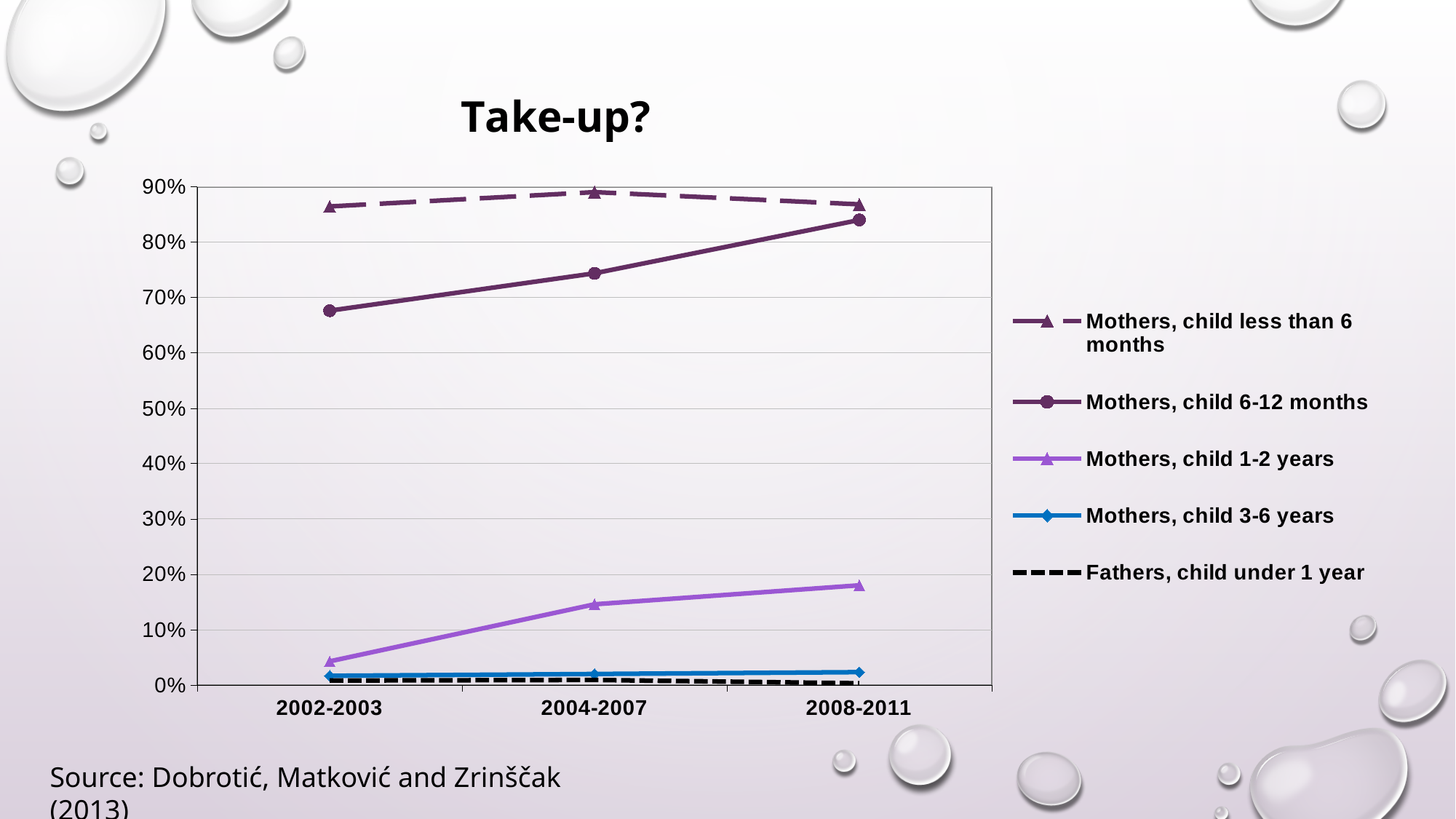
In 2004-2007, which is larger: Mothers, child less than 6 months or Mothers, child 6-12 months? Mothers, child less than 6 months Is the value for Mothers, child 6-12 months in 2008-2011 greater or less than 80%? greater How many series does the legend list? 5 What is the title of the chart? Take-up? Is the value for Mothers, child 1-2 years in 2008-2011 greater or less than 20%? less Is the value for Mothers, child 6-12 months in 2002-2003 greater or less than 70%? less What kind of chart is shown on the slide? line chart Which series has the highest value in 2002-2003? Mothers, child less than 6 months Does the value for Mothers, child 6-12 months rise or fall from 2002-2003 to 2008-2011? rise How many time periods are shown on the x axis? 3 Does the value for Mothers, child 1-2 years rise or fall across the periods shown? rise